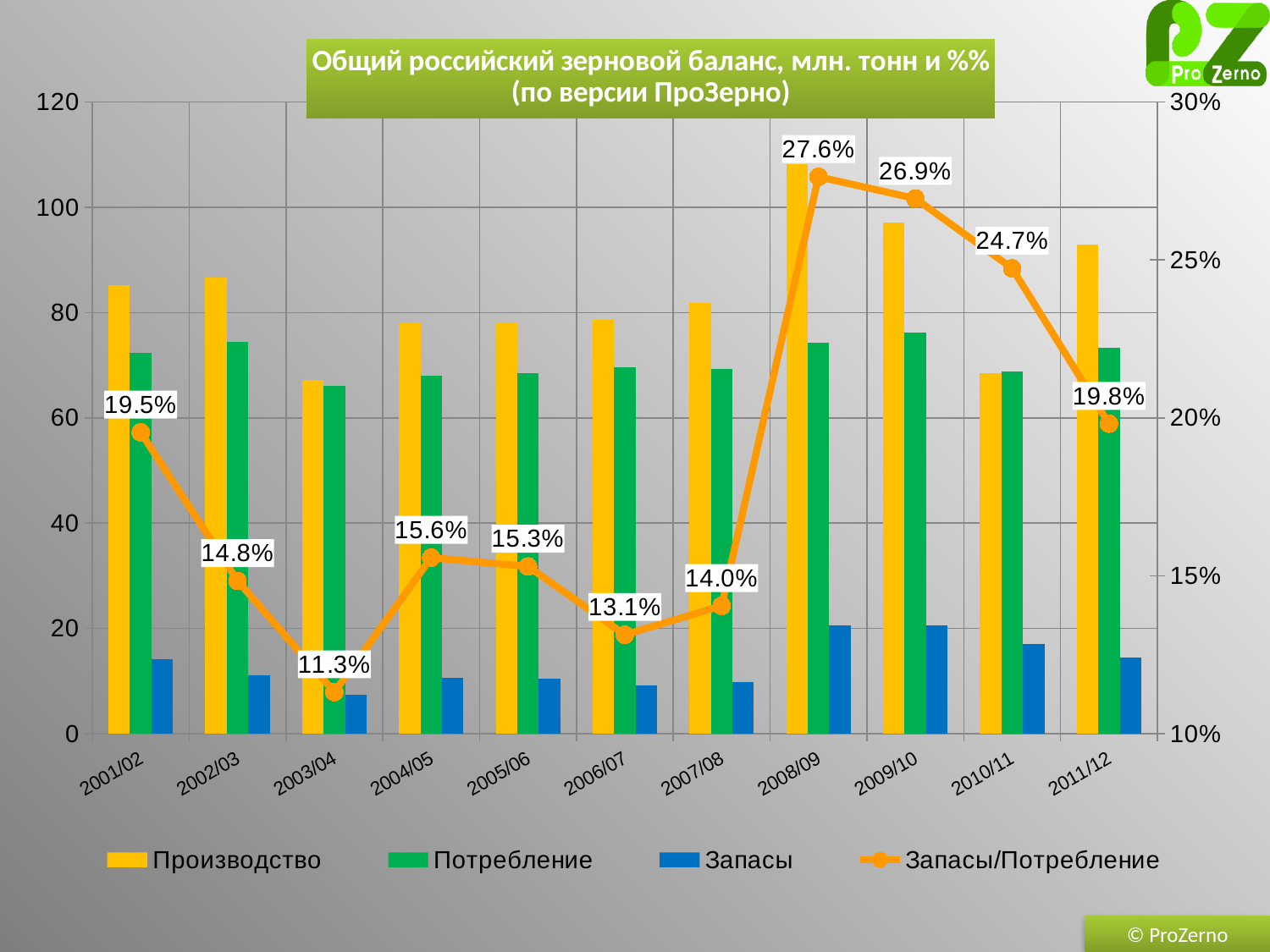
Which is larger, Запасы/Потребление in 2001/02 or in 2011/12? 2011/12 How many seasons are shown on the x axis? 11 What is the difference between Запасы/Потребление in 2008/09 and 2009/10? 0.7% Is the Запасы value for 2003/04 greater or less than 20? less In which season is Запасы/Потребление lowest? 2003/04 What is the value of Запасы/Потребление for 2011/12? 19.8% How many series does the legend list? 4 In which season is Запасы/Потребление highest? 2008/09 What is the value of Запасы/Потребление for 2003/04? 11.3% Is the Производство value for 2008/09 greater or less than 100? greater Does Запасы/Потребление rise or fall from 2008/09 to 2011/12? fall What is the value of Запасы/Потребление for 2008/09? 27.6%